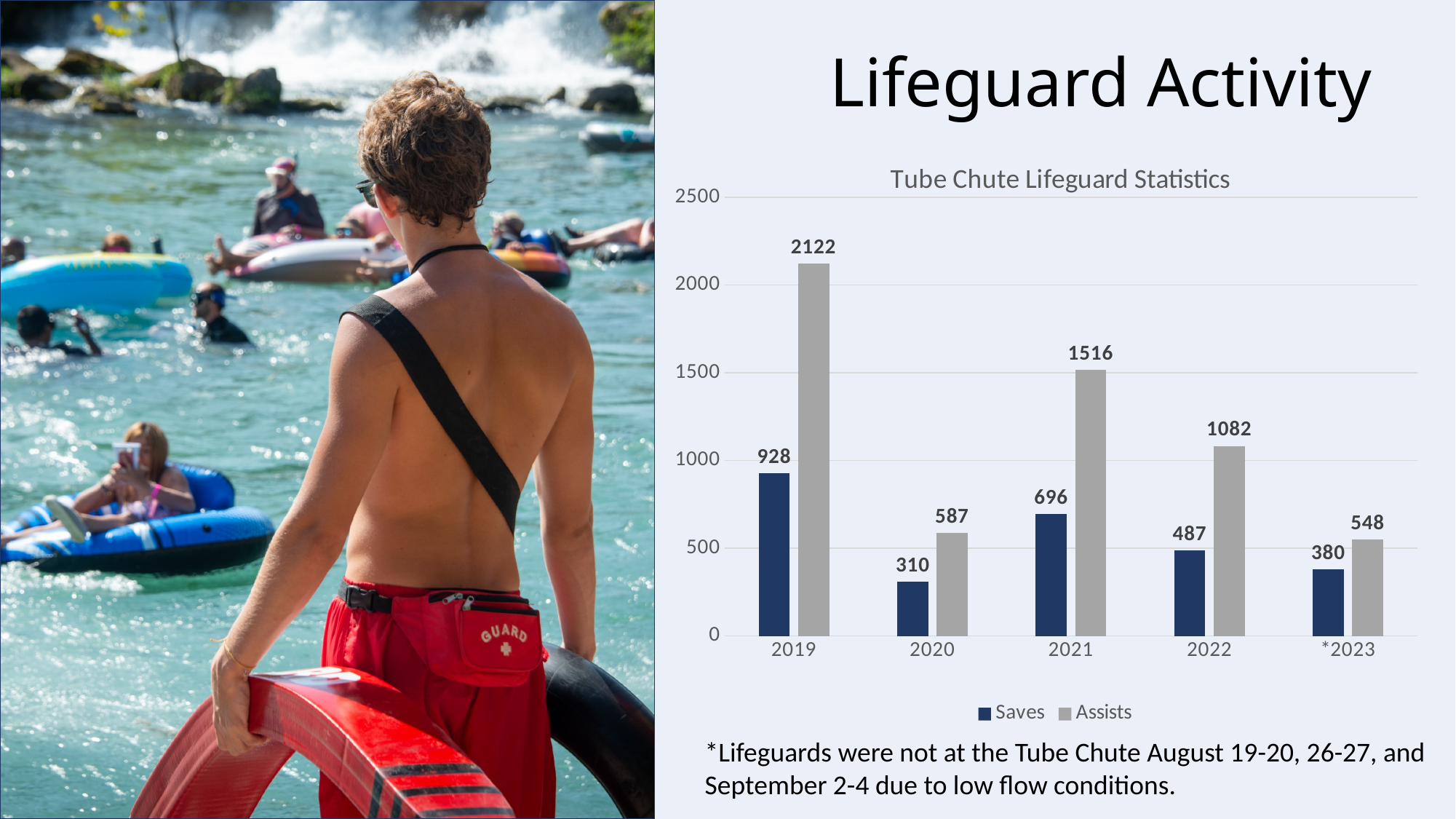
What is the number of Assists in 2021? 1516 What is the number of Saves in 2019? 928 Is the value for Assists in 2019 greater or less than 2000? greater Which year has the highest number of Assists? 2019 How many years are shown on the x axis? 5 How many series does the legend list? 2 Which year has the lowest number of Saves? 2020 What is the title of the chart? Tube Chute Lifeguard Statistics What is the difference between Assists and Saves in 2022? 595 What kind of chart is shown? bar chart What is the number of Assists in *2023? 548 Which is larger: Saves in 2021 or Assists in 2020? Saves in 2021